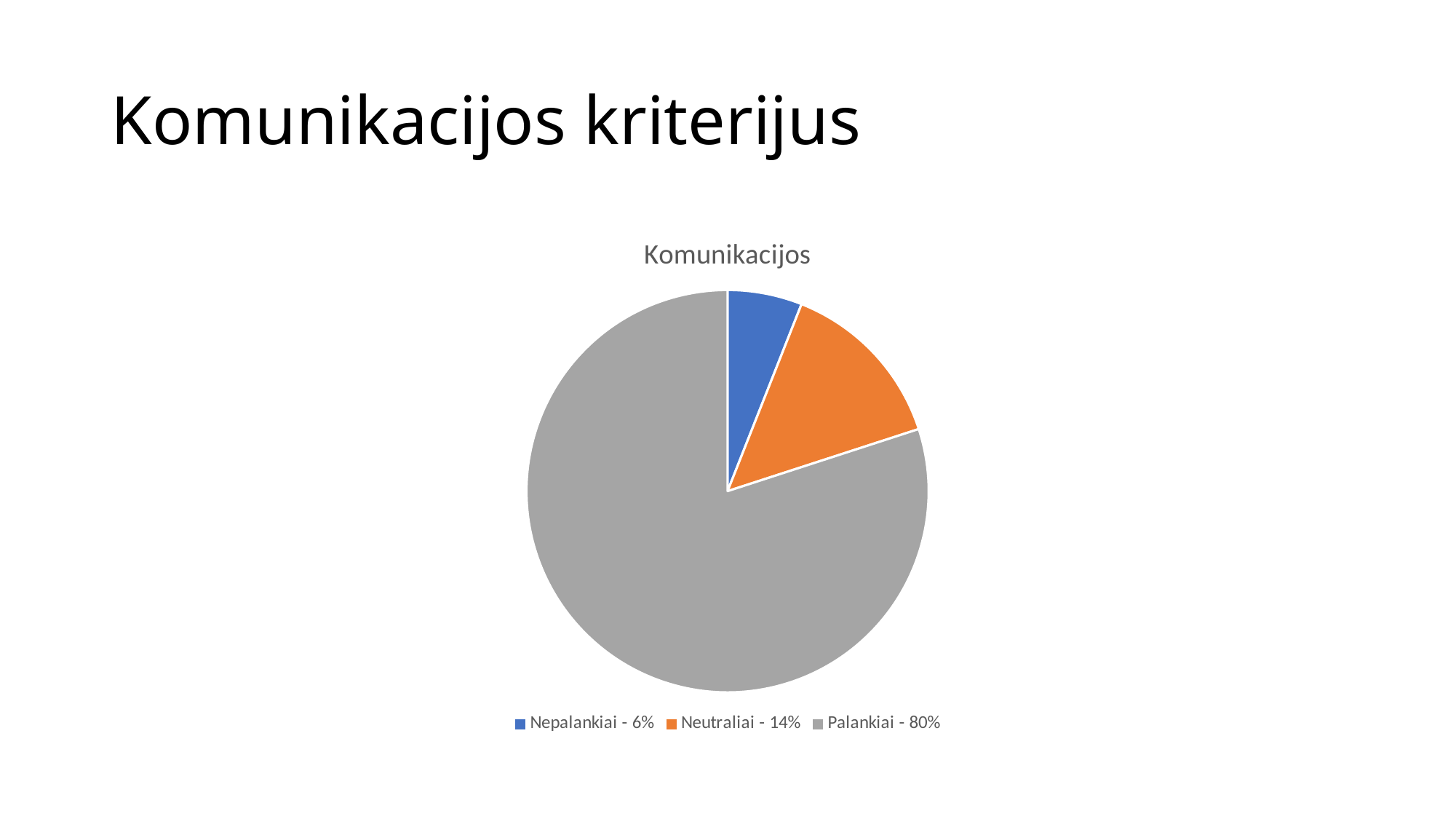
What colour is the Palankiai slice? grey Which category has the smallest slice? Nepalankiai What share of the pie does Palankiai represent? 80% Which is larger, the Neutraliai slice or the Nepalankiai slice? Neutraliai What share of the pie does Neutraliai represent? 14% What is the difference between the Palankiai and Neutraliai shares? 66% How many slices does the pie chart have? 3 What kind of chart is shown on the slide? pie chart What share of the pie does Nepalankiai represent? 6% What is the title of the chart? Komunikacijos Which category has the largest slice? Palankiai What is the difference between the Neutraliai and Nepalankiai shares? 8%